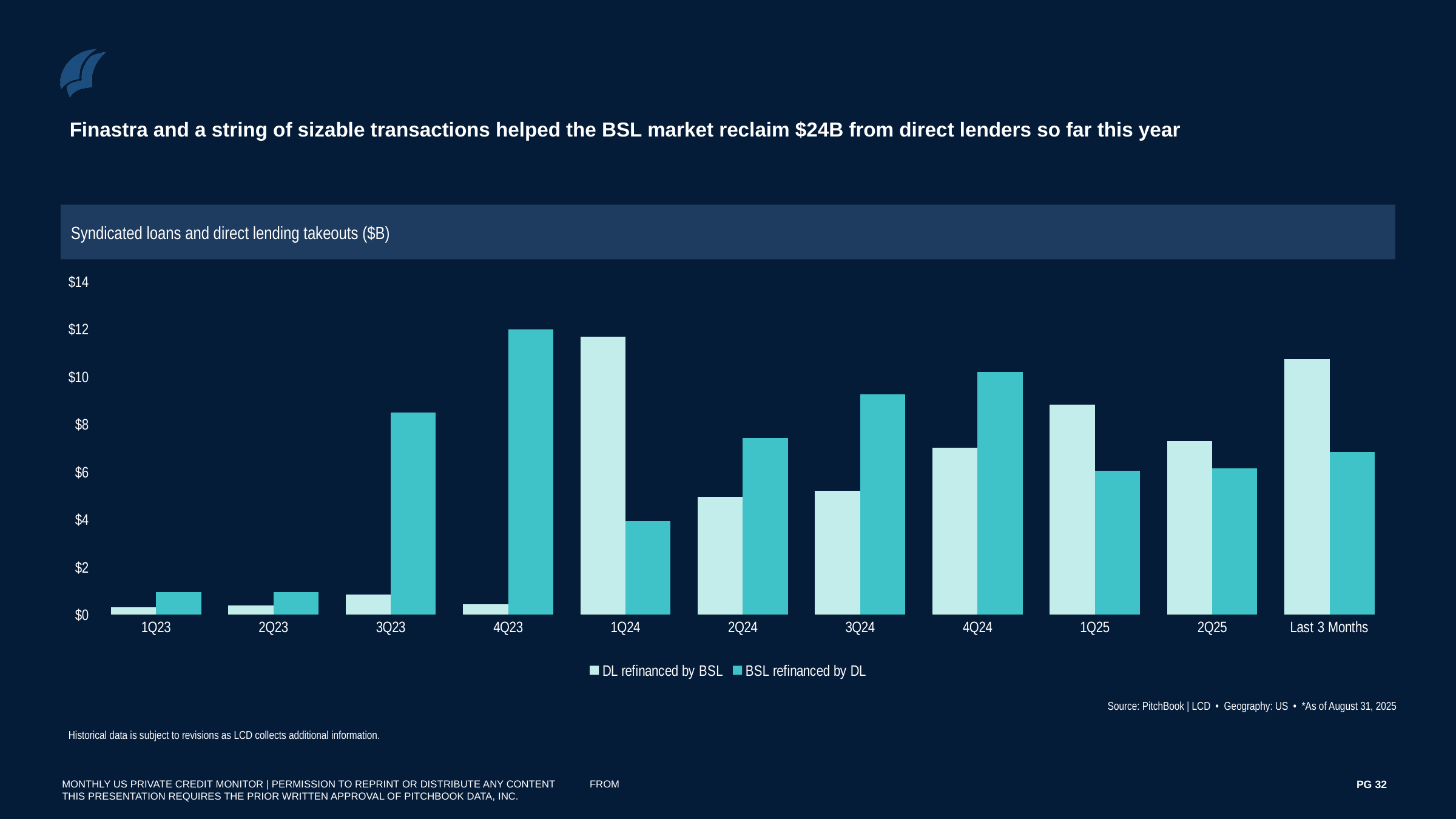
In which period is the value for BSL refinanced by DL highest? 4Q23 In 4Q24, which is larger: DL refinanced by BSL or BSL refinanced by DL? BSL refinanced by DL In 1Q24, which is larger: DL refinanced by BSL or BSL refinanced by DL? DL refinanced by BSL Is the value for BSL refinanced by DL in 1Q25 greater or less than $8? less What is the title of the chart? Syndicated loans and direct lending takeouts ($B) Is the value for BSL refinanced by DL in 4Q23 greater or less than $10? greater How many series does the legend list? 2 What kind of chart is shown on the slide? Bar chart Is the value for DL refinanced by BSL in the Last 3 Months greater or less than $10? greater In which period is the value for DL refinanced by BSL highest? 1Q24 How many periods are shown along the x axis? 11